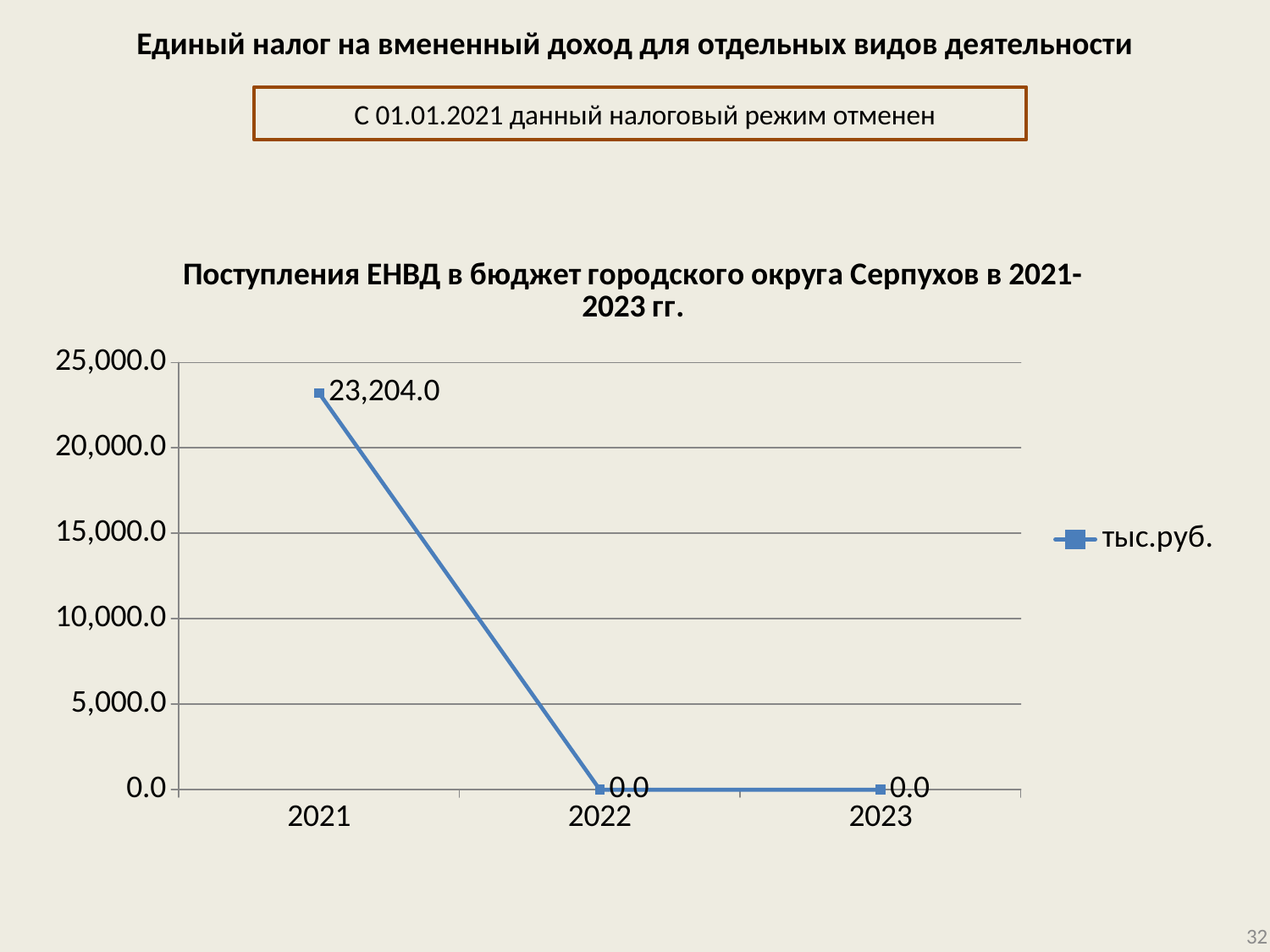
Do the values rise or fall from 2021 to 2022? fall What is the difference between the values for 2021 and 2022? 23,204.0 What kind of chart is shown? line chart What is the value for 2022? 0.0 What is the value for 2021? 23,204.0 How many series does the legend list? 1 Which is larger, the value for 2021 or the value for 2023? 2021 How many years are plotted on the x axis? 3 What is the value for 2023? 0.0 Which year has the highest value? 2021 What is the legend entry for the series? тыс.руб. Is the value for 2021 greater or less than 20,000.0? greater